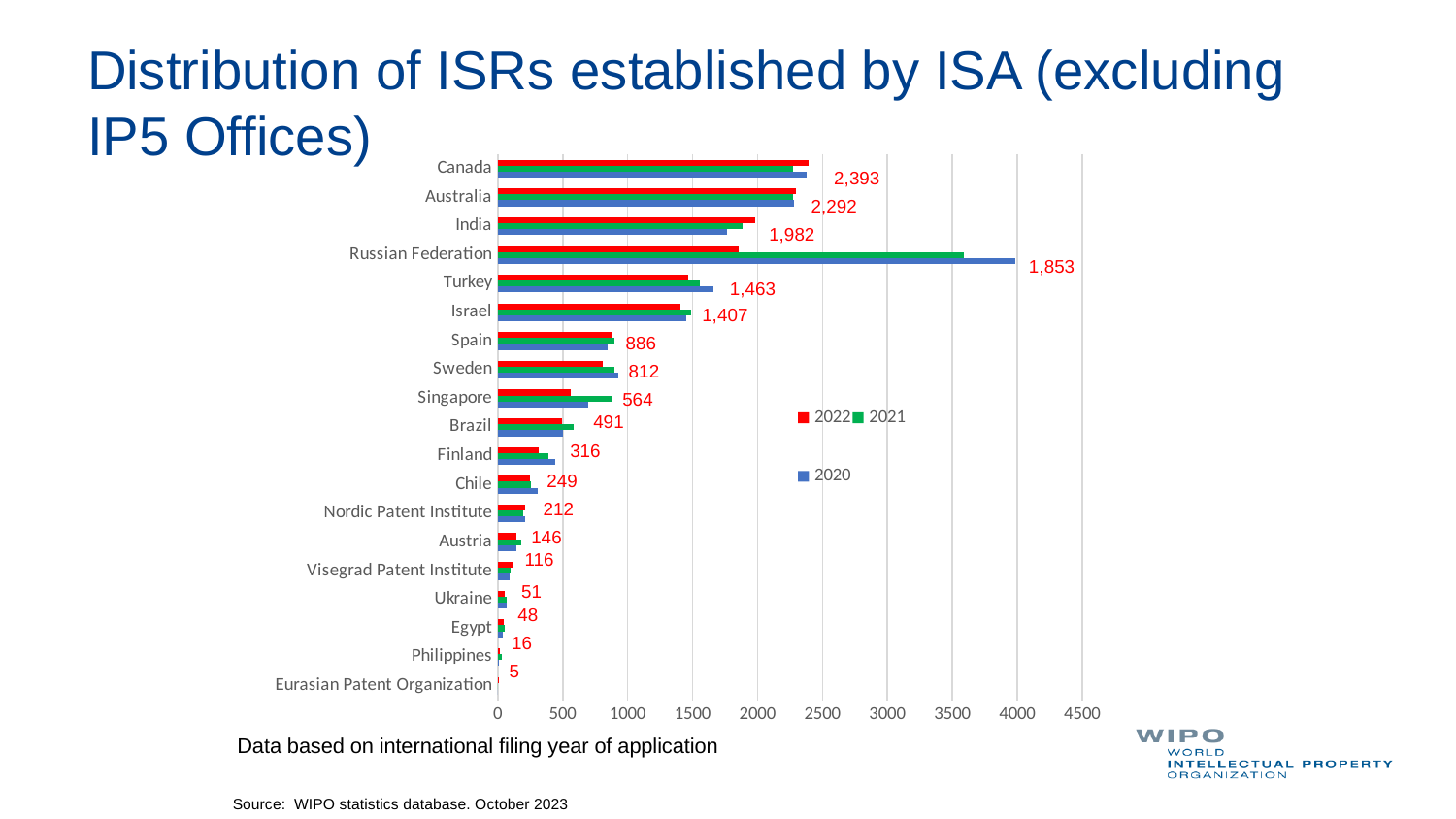
What is the 2022 value for the Visegrad Patent Institute? 116 How many ISAs are listed on the chart? 19 What kind of chart is shown on the slide? Bar chart What is the difference between the 2022 values for Canada and Australia? 101 What is the 2022 value for Canada? 2,393 Which has the larger 2022 value, Spain or Sweden? Spain What is the 2022 value for Singapore? 564 What is the 2022 value for the Russian Federation? 1,853 How many series does the legend list? 3 Which ISA has the highest 2022 value? Canada Is the 2020 value for the Russian Federation greater or less than 3500? greater Which ISA has the lowest 2022 value? Eurasian Patent Organization